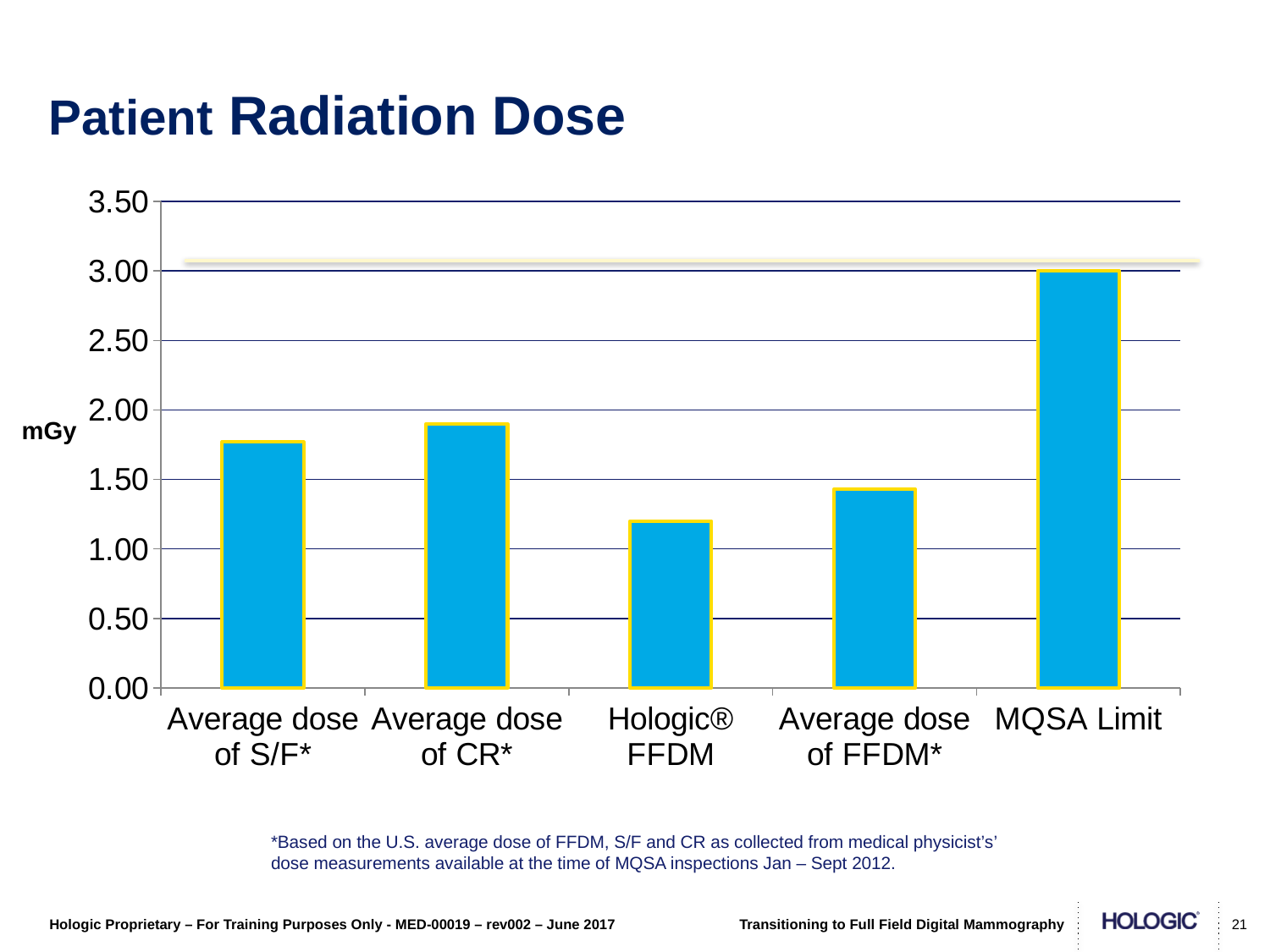
What unit is shown on the y axis of the chart? mGy Is the value for Average dose of FFDM* greater or less than 1.50? less Which is larger, the value for Average dose of CR* or the value for Average dose of S/F*? Average dose of CR* What is the value for MQSA Limit? 3.00 What kind of chart is shown on the slide? bar chart Is the value for Average dose of CR* greater or less than 2.00? less Which category has the highest value? MQSA Limit How many categories are plotted on the x axis? 5 Is the value for Hologic® FFDM greater or less than 1.00? greater Which category has the lowest value? Hologic® FFDM Which is larger, the value for Average dose of FFDM* or the value for Hologic® FFDM? Average dose of FFDM*